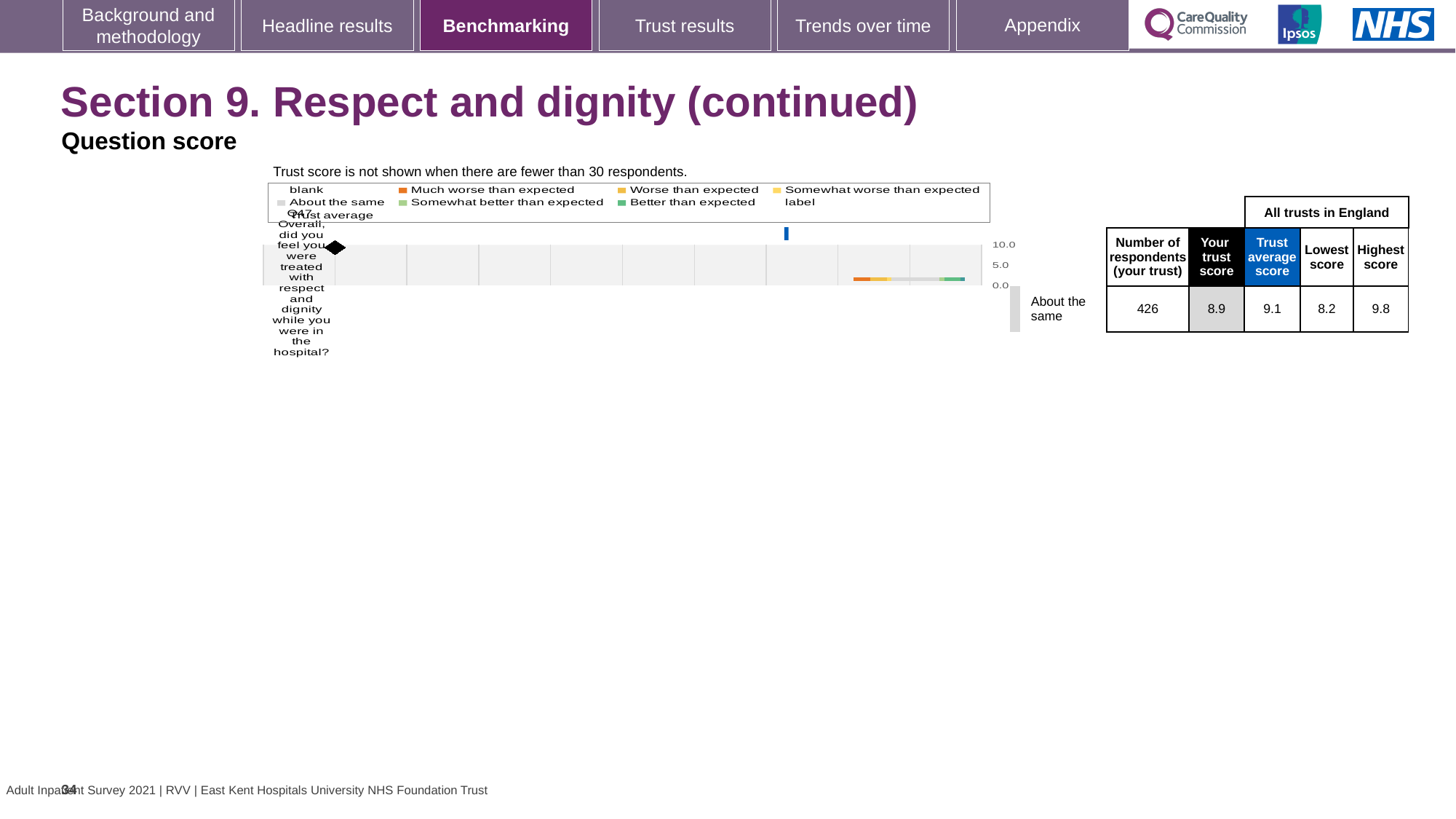
What is the trust's score for Q47 shown in the 'Your trust score' column? 8.9 What is the lowest score among all trusts in England for Q47? 8.2 What benchmark category label is shown next to the chart for Q47? About the same What is the highest score among all trusts in England for Q47? 9.8 What is the trust average score for all trusts in England for Q47? 9.1 What is the difference between the highest score and the lowest score for Q47? 1.6 Is the trust's score for Q47 higher or lower than the trust average score? lower How many respondents from the trust answered Q47? 426 What is the difference between the trust average score and the trust's own score for Q47? 0.2 Which legend entry is shown in orange? Much worse than expected How many questions are plotted on the chart? 1 What kind of chart is shown on the slide? bar chart